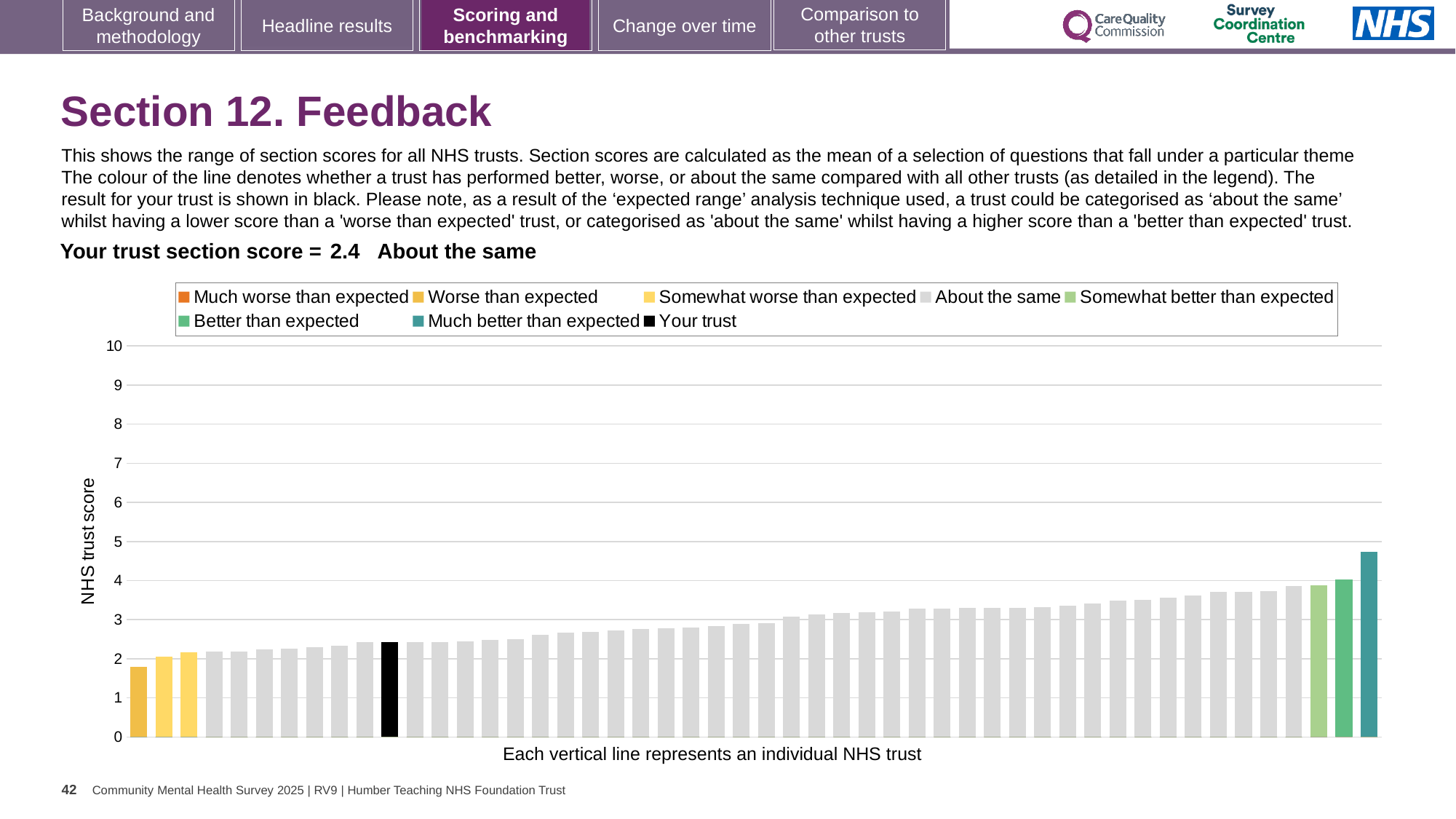
Which is taller: the black 'Your trust' bar or the leftmost bar on the chart? the black 'Your trust' bar What is the label on the vertical axis of the chart? NHS trust score How many entries does the chart legend list? 8 Do the bar values rise or fall moving from left to right along the x axis? rise Which legend category does the tallest bar on the chart belong to? Much better than expected Which category is your trust placed in for this section? About the same Is the value of the leftmost (shortest) bar greater or less than 2? less Is the value of the tallest bar on the chart greater or less than 4? greater What is the section score for your trust shown on the slide? 2.4 Is the value of the tallest bar on the chart greater or less than 5? less What kind of chart is shown on the slide? bar chart